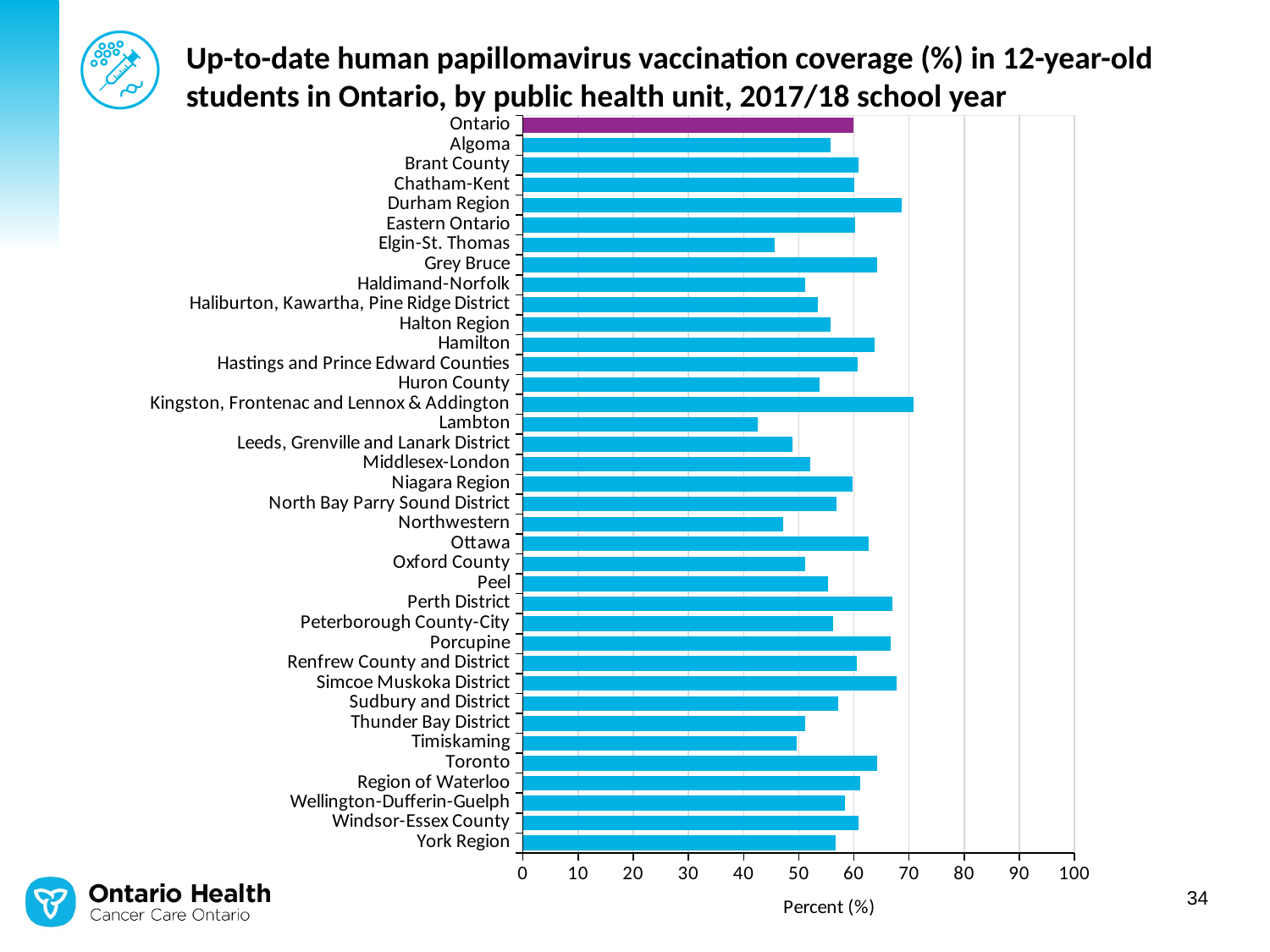
How many bars are plotted on the chart, including Ontario? 37 What kind of chart is shown on the slide? bar chart Is the value for Durham Region greater or less than 60? greater Is the value for Perth District greater or less than 60? greater Which public health unit has the highest HPV vaccination coverage? Kingston, Frontenac and Lennox & Addington Which has the higher coverage, Durham Region or Algoma? Durham Region What is the label of the horizontal axis? Percent (%) Which has the higher coverage, Toronto or Lambton? Toronto Is the value for Northwestern greater or less than 50? less Which public health unit has the lowest HPV vaccination coverage? Lambton